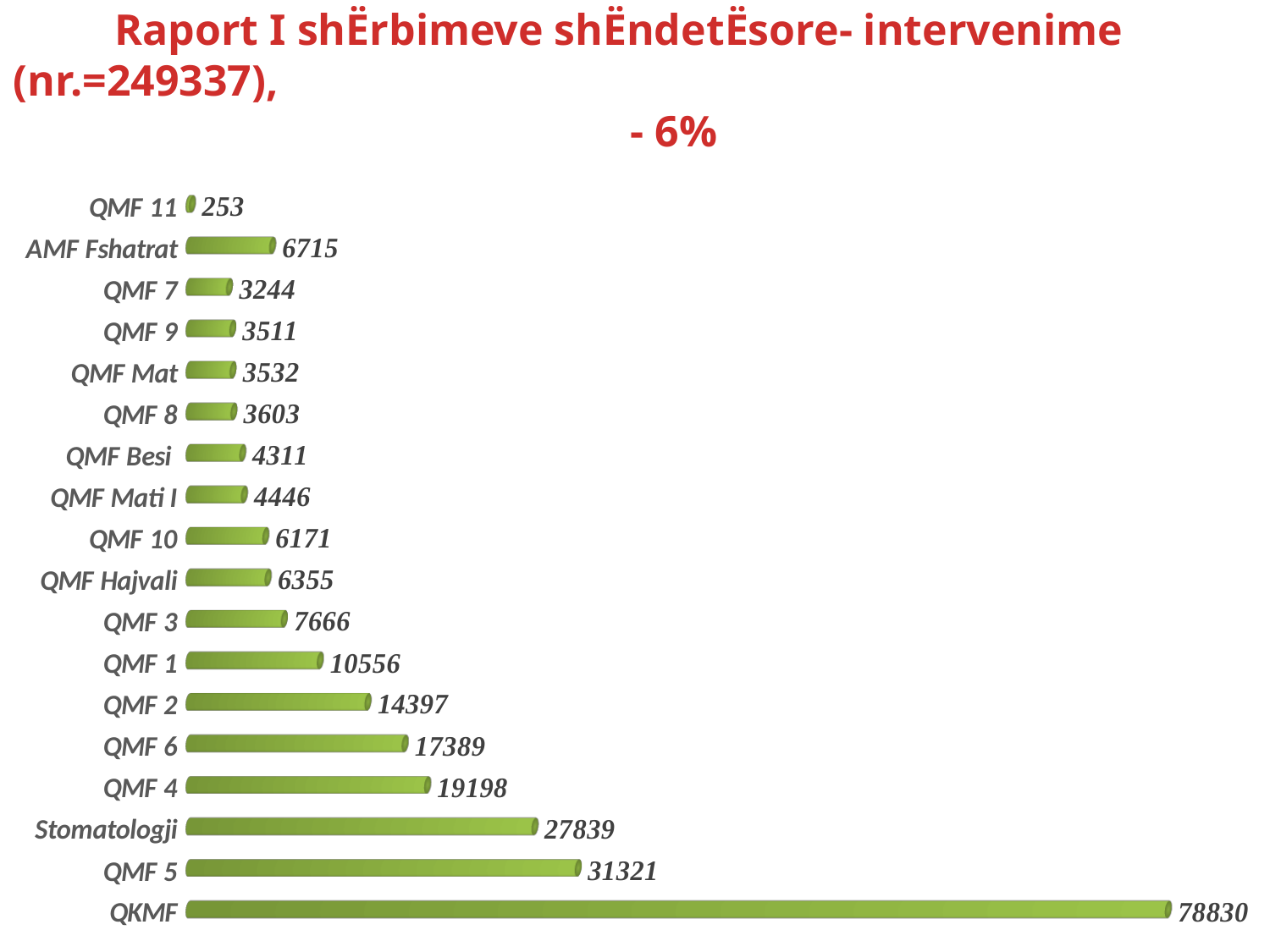
Which is larger, the value for QMF 2 or the value for QMF 1? QMF 2 What is the value for Stomatologji? 27839 What colour are the bars in the chart? Green What is the difference between the values for QMF 5 and QMF 4? 12123 What is the difference between the values for QKMF and QMF 5? 47509 Which category has the lowest value? QMF 11 What is the value for QMF Hajvali? 6355 What is the value for AMF Fshatrat? 6715 Which category has the highest value? QKMF What kind of chart is shown on the slide? Bar chart How many categories are shown in the chart? 18 What is the value for QKMF? 78830